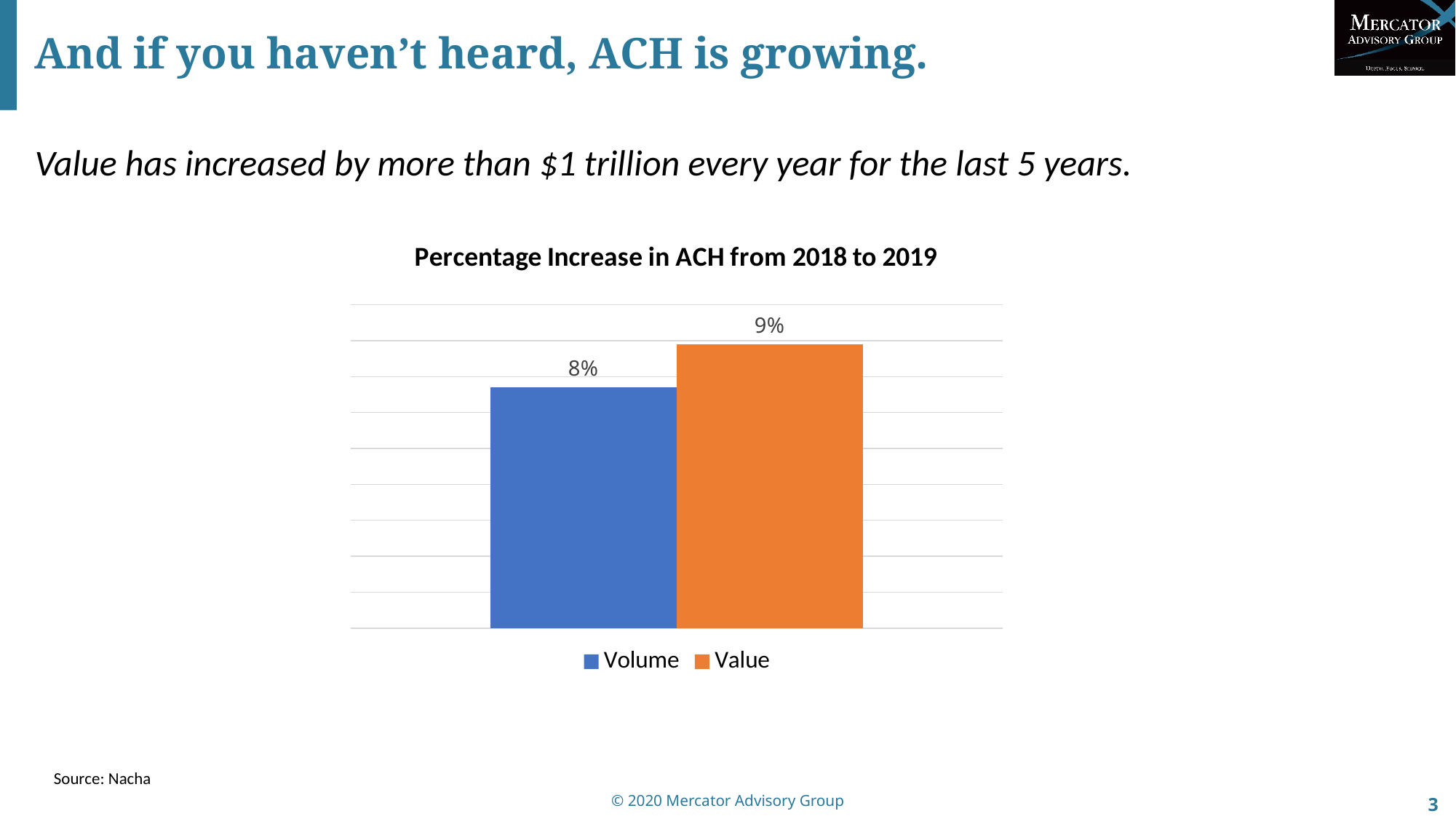
Which series shows the higher percentage increase, Volume or Value? Value What is the title of the chart? Percentage Increase in ACH from 2018 to 2019 What is the percentage increase in ACH Volume from 2018 to 2019? 8% How many series does the chart legend list? 2 What colour is the bar for Value? orange What is the percentage increase in ACH Value from 2018 to 2019? 9% How many bars are plotted in the chart? 2 What is the difference between the percentage increase in Value and the percentage increase in Volume? 1% What kind of chart is shown on the slide? bar chart Which series shows the lower percentage increase, Volume or Value? Volume Is the percentage increase for Value larger or smaller than the percentage increase for Volume? larger